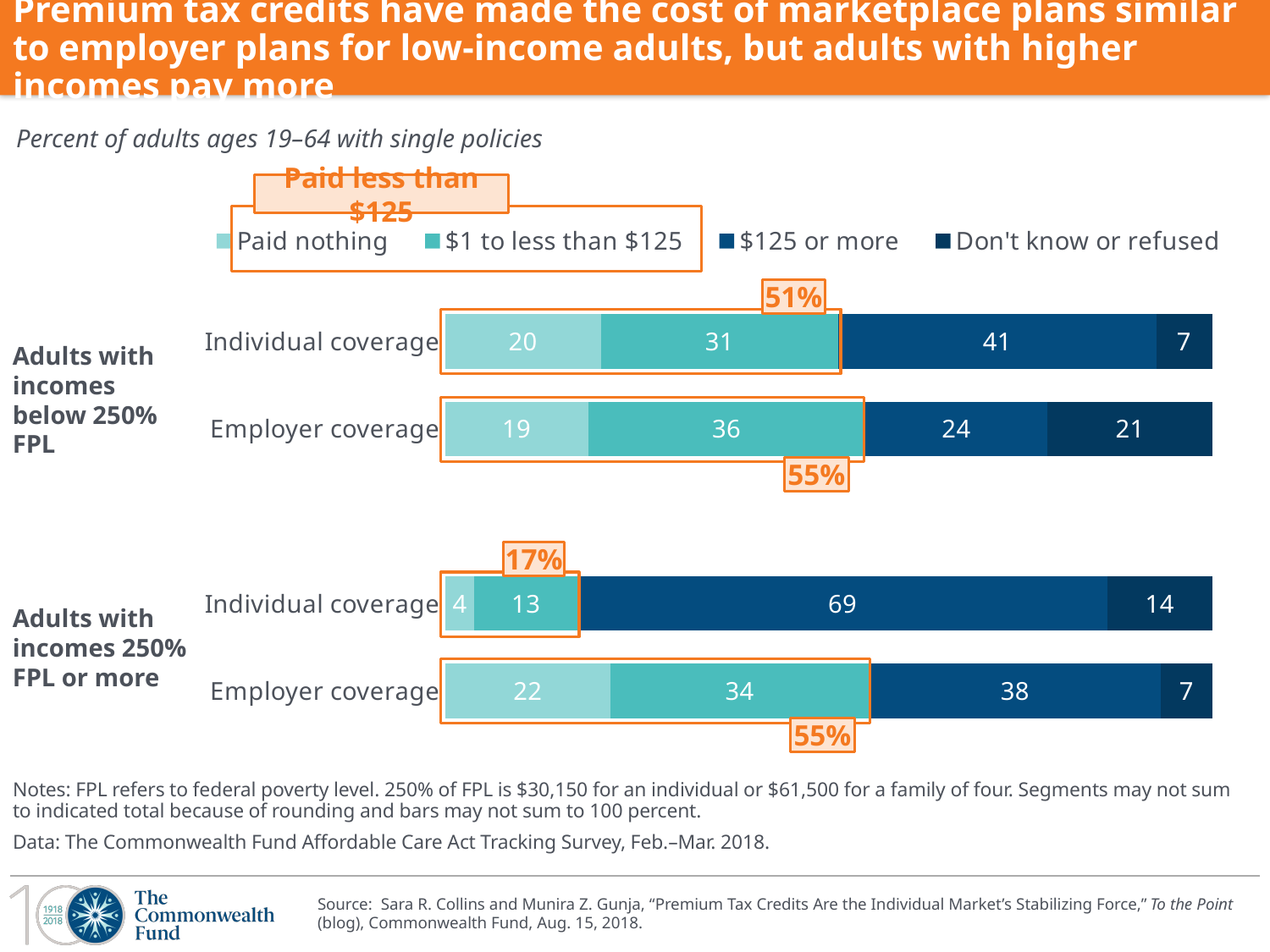
For adults with incomes below 250% FPL, which is larger: the '$1 to less than $125' value for individual coverage or for employer coverage? Employer coverage For adults with incomes 250% FPL or more, what is the difference between the '$125 or more' values for individual coverage and employer coverage? 31 How many series does the legend list? 4 What kind of chart is shown on the slide? Stacked bar chart For adults with incomes below 250% FPL, what percent with individual coverage paid $125 or more? 41 How many bars are plotted in the chart? 4 What is the 'Paid less than $125' total shown for employer coverage among adults with incomes below 250% FPL? 55% Which bar has the highest value for the '$125 or more' segment? Individual coverage, adults with incomes 250% FPL or more For adults with incomes below 250% FPL, what percent with employer coverage answered 'Don't know or refused'? 21 For adults with incomes 250% FPL or more, what percent with individual coverage paid $125 or more? 69 What is the 'Paid less than $125' total shown for individual coverage among adults with incomes 250% FPL or more? 17% Which bar has the lowest value for the 'Paid nothing' segment? Individual coverage, adults with incomes 250% FPL or more